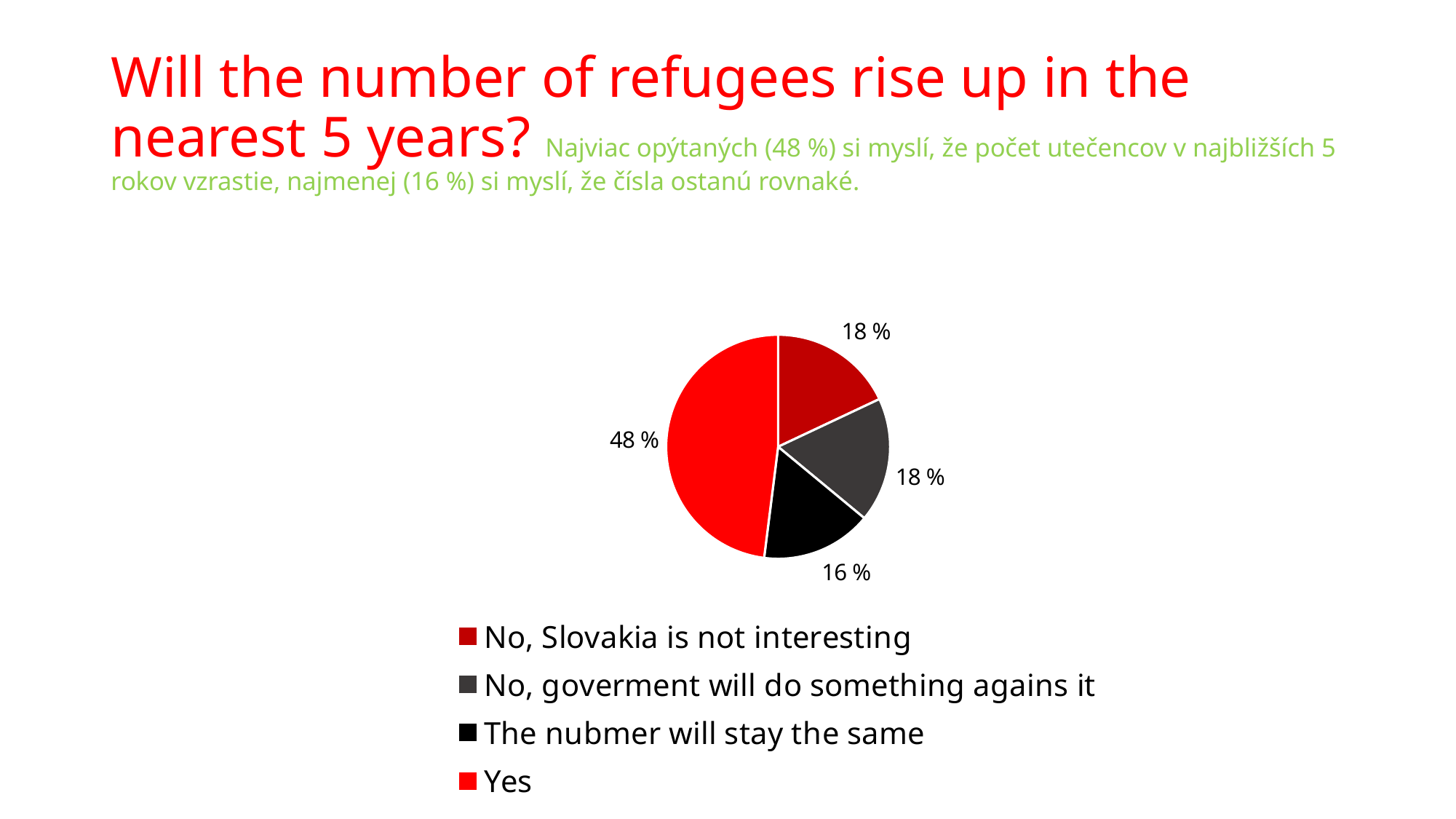
Which answer has the largest share of the pie? Yes What share of respondents answered "The nubmer will stay the same"? 16 % What is the difference between the share for "Yes" and the share for "The nubmer will stay the same"? 32 % Which answer has the smallest share of the pie? The nubmer will stay the same How many categories does the legend list? 4 What share of respondents answered "No, goverment will do something agains it"? 18 % Which is larger: the share for "Yes" or the share for "No, Slovakia is not interesting"? Yes What colour is the slice for "Yes"? red What share of respondents answered "Yes"? 48 % What share of respondents answered "No, Slovakia is not interesting"? 18 % What kind of chart is shown on the slide? pie chart What is the combined share of the two "No" answers? 36 %